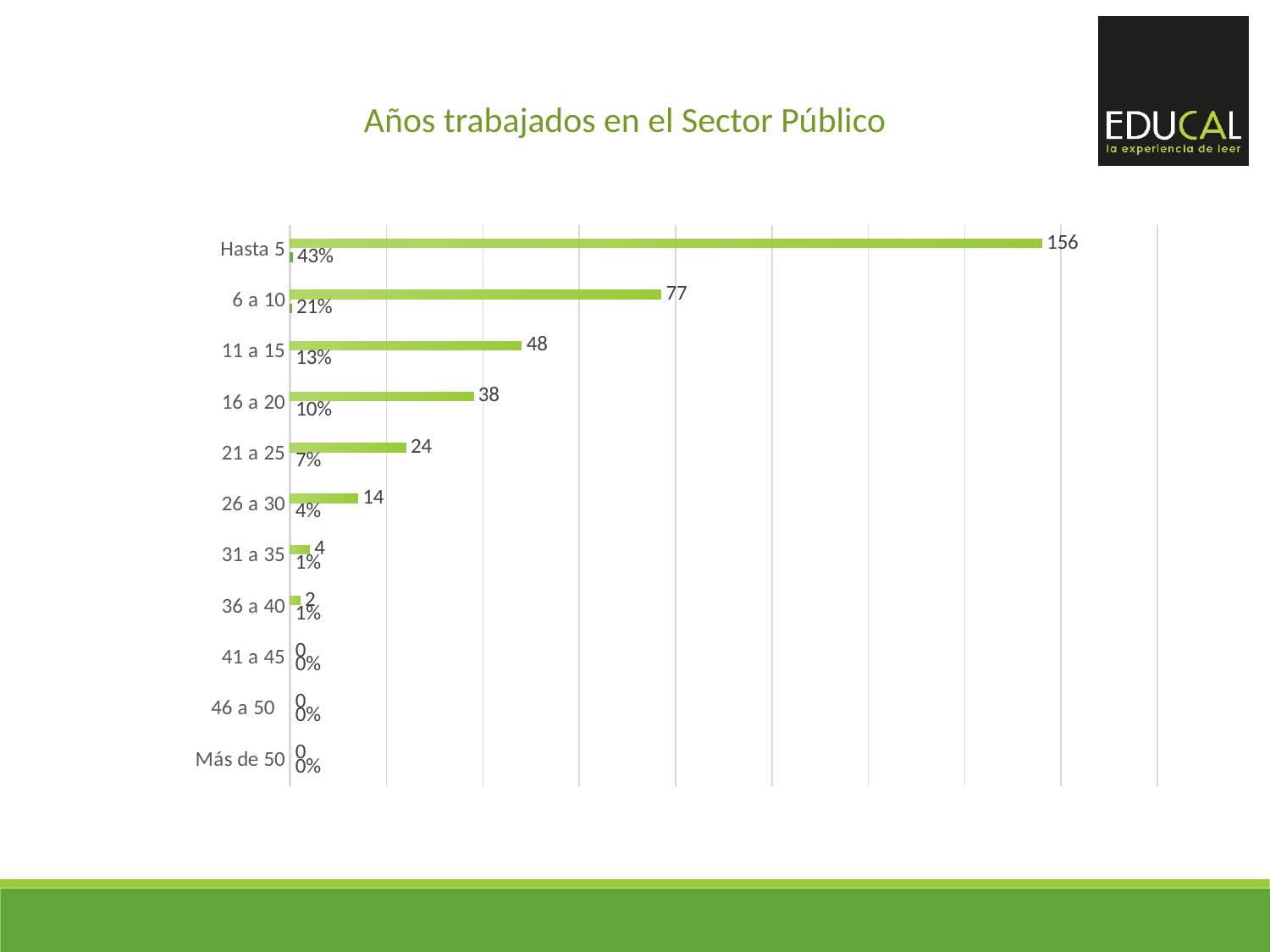
Which has a larger count, "21 a 25" or "26 a 30"? 21 a 25 What percentage is shown for the "26 a 30" category? 4% How many categories are shown on the chart? 11 What is the difference between the counts for "11 a 15" and "16 a 20"? 10 What is the count value for the "16 a 20" category? 38 Which category has the highest count? Hasta 5 What is the count value for the "Hasta 5" category? 156 Do the count values rise or fall going from "Hasta 5" down to "Más de 50"? Fall What percentage is shown for the "6 a 10" category? 21% What kind of chart is shown on the slide? Bar chart What is the difference between the counts for "Hasta 5" and "6 a 10"? 79 What is the title of the chart? Años trabajados en el Sector Público